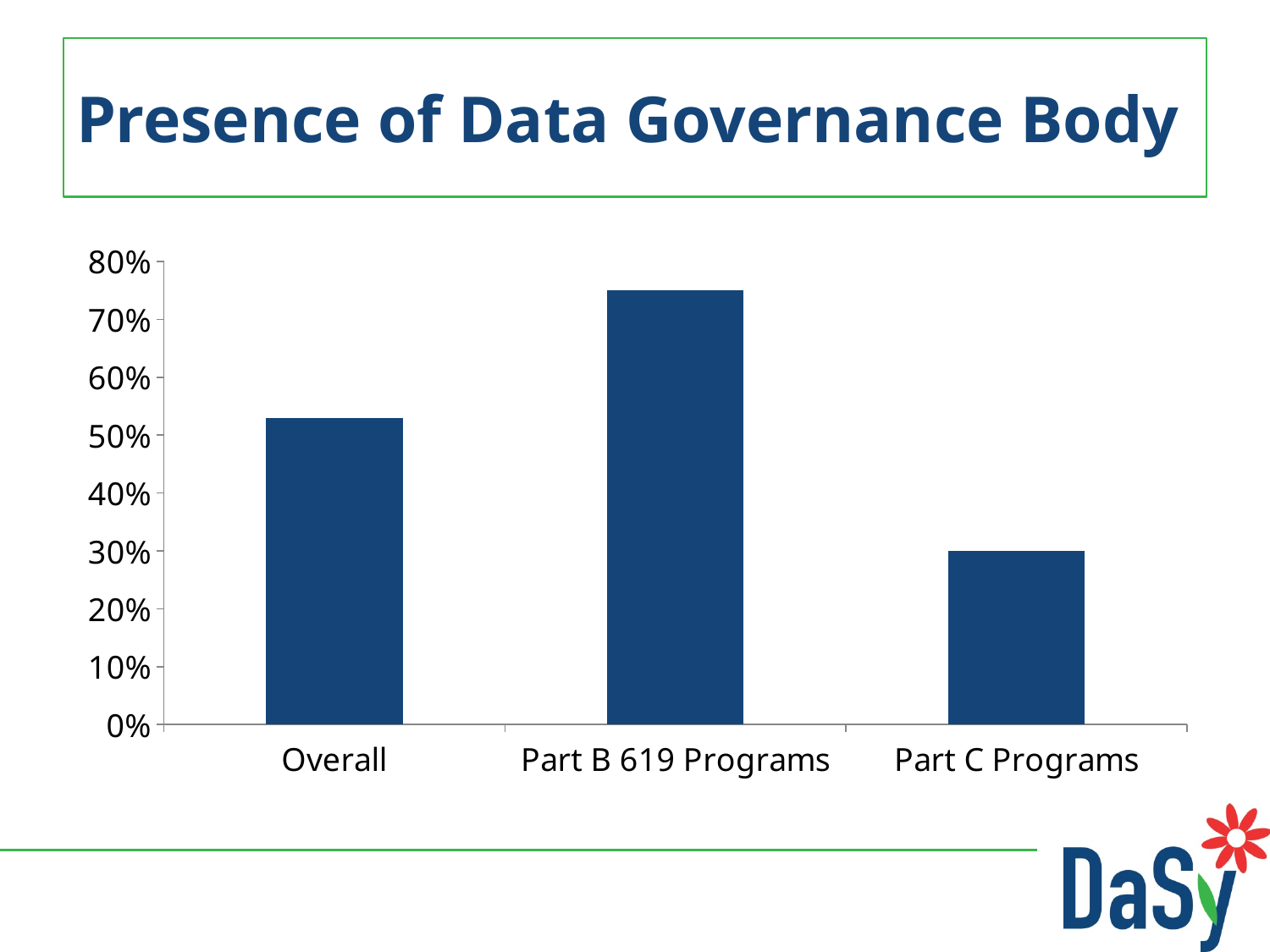
How many categories are shown on the x axis? 3 Which is larger, the value for Overall or the value for Part C Programs? Overall Which is larger, the value for Part B 619 Programs or the value for Overall? Part B 619 Programs Is the value for Overall greater or less than 50%? greater Is the value for Part B 619 Programs greater or less than 70%? greater Which category has the highest value? Part B 619 Programs What kind of chart is shown on the slide? bar chart Is the value for Overall greater or less than 60%? less Which category has the lowest value? Part C Programs What is the title of the slide? Presence of Data Governance Body